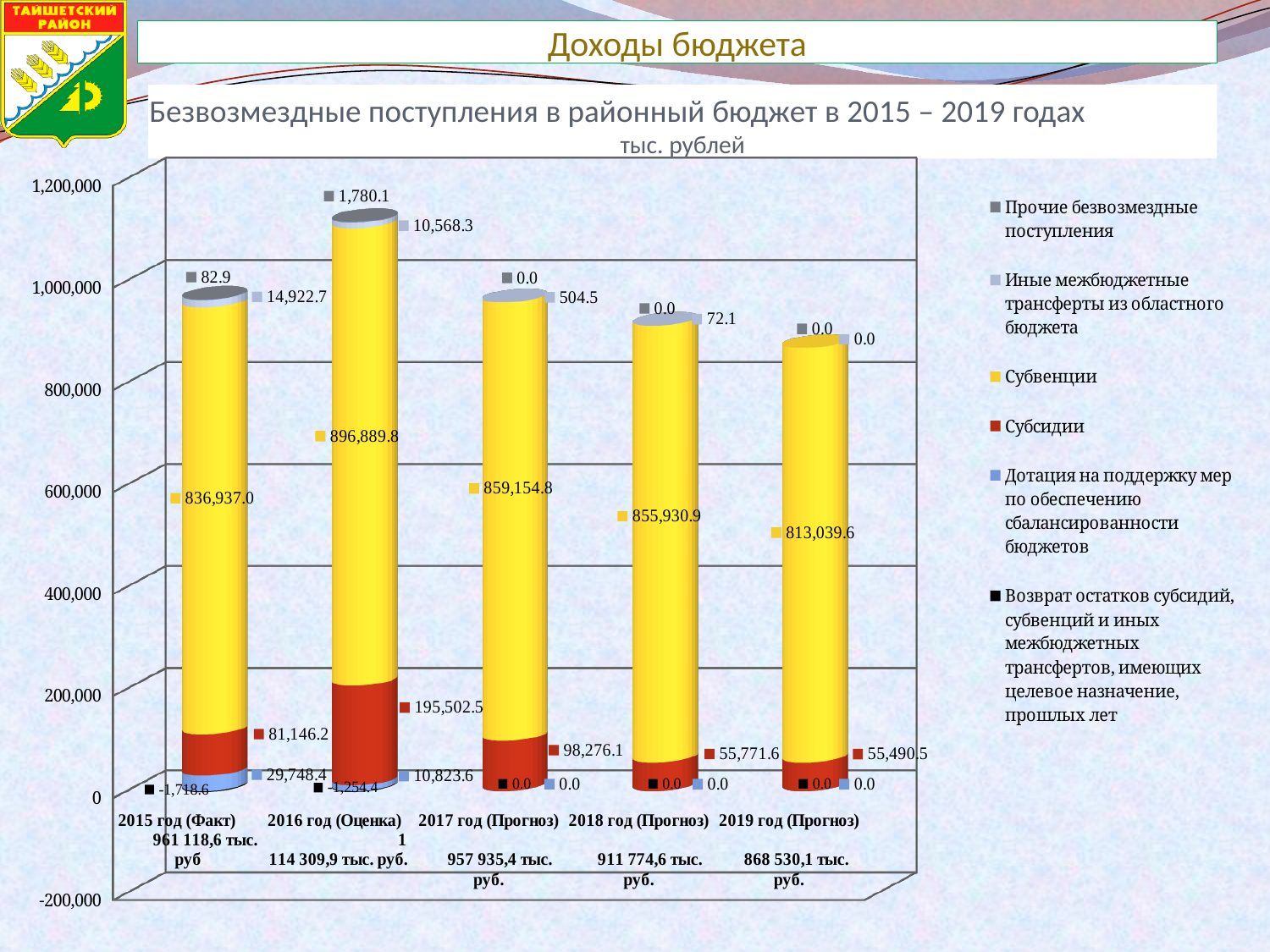
What is the difference between the Субсидии values for 2016 год (Оценка) and 2015 год (Факт)? 114,356.3 How many years (categories) are shown on the x axis? 5 What is the value of Субсидии for 2016 год (Оценка)? 195,502.5 Which is larger: Субсидии for 2017 год (Прогноз) or Субсидии for 2018 год (Прогноз)? 2017 год (Прогноз) What is the value of Иные межбюджетные трансферты из областного бюджета for 2017 год (Прогноз)? 504.5 What is the total of the stacked bar for 2016 год (Оценка), as printed on the slide? 1 114 309,9 тыс. руб. In which year is the value of Субвенции the lowest? 2019 год (Прогноз) What is the value of Дотация на поддержку мер по обеспечению сбалансированности бюджетов for 2015 год (Факт)? 29,748.4 What is the value of Субвенции for 2015 год (Факт)? 836,937.0 How many series does the legend list? 6 In which year is the value of Субвенции the highest? 2016 год (Оценка) What kind of chart is shown on the slide? Stacked bar chart